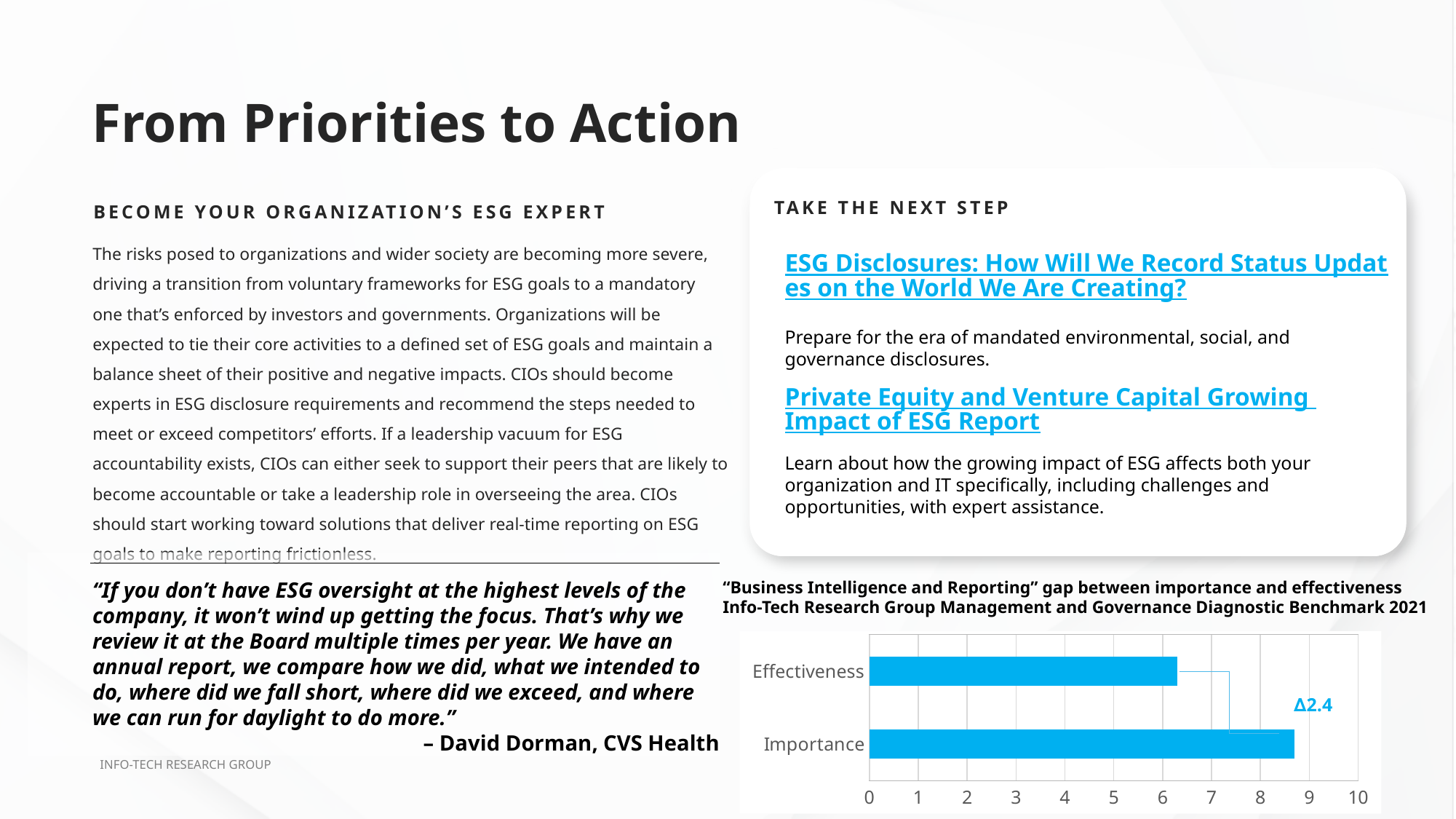
Which category in the bar chart has the lower value? Effectiveness Is the value for Importance in the bar chart greater or less than 8? greater What gap between Importance and Effectiveness is annotated on the bar chart? Δ2.4 How many categories does the bar chart show? 2 In the bar chart, is the value for Importance larger or smaller than the value for Effectiveness? larger Is the value for Effectiveness in the bar chart greater or less than 6? greater Is the value for Effectiveness in the bar chart greater or less than 7? less Which benchmark is the bar chart's data attributed to, according to its caption? Info-Tech Research Group Management and Governance Diagnostic Benchmark 2021 What kind of chart is shown at the bottom right of the slide? bar chart Which category in the bar chart has the higher value? Importance What is the highest value shown on the horizontal axis of the bar chart? 10